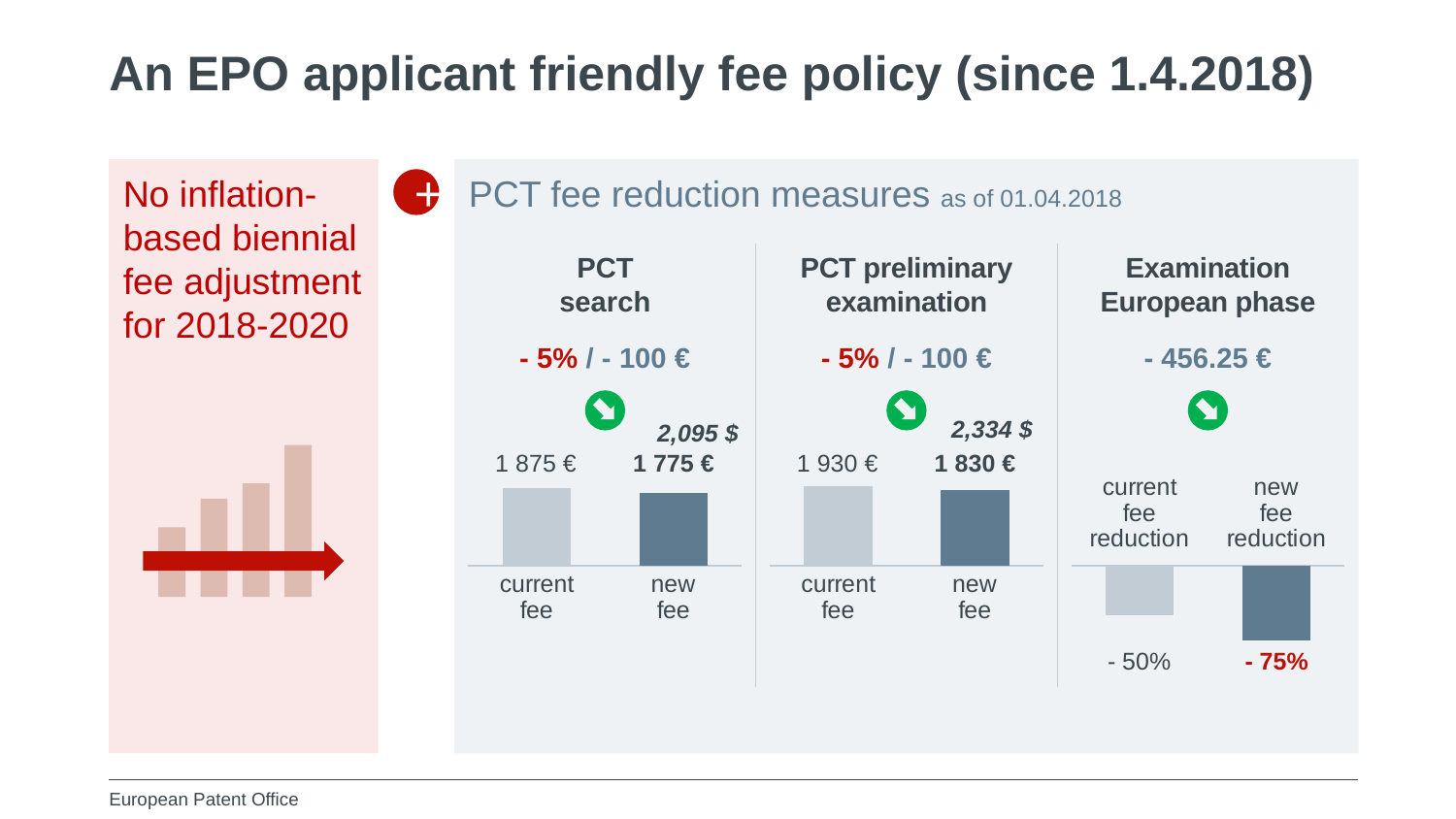
What kind of chart is used for the PCT search fees? bar chart In the PCT search chart, what is the difference between the current fee and the new fee? 100 € In the PCT preliminary examination chart, what is the current fee? 1 930 € In the PCT preliminary examination chart, what is the new fee? 1 830 € In the PCT search chart, what is the current fee? 1 875 € In the PCT search chart, which bar is lower, current fee or new fee? new fee In the Examination European phase chart, what is the new fee reduction? - 75% In the Examination European phase chart, what is the current fee reduction? - 50% In the PCT preliminary examination chart, what is the new fee shown in dollars? 2,334 $ In the PCT search chart, what is the new fee? 1 775 € In the PCT preliminary examination chart, which is larger, the current fee or the new fee? current fee How many bars does the PCT preliminary examination chart show? 2